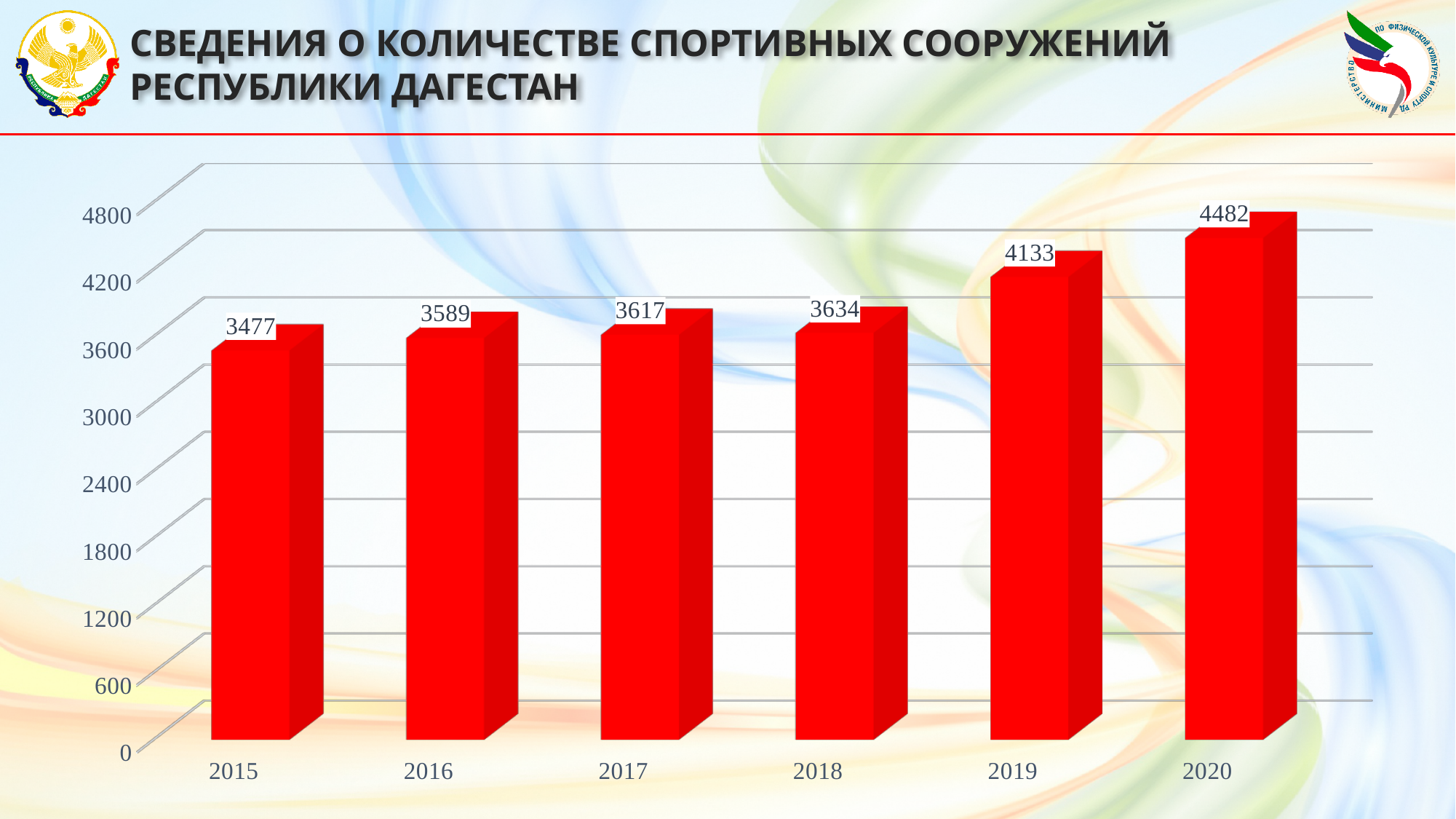
What is the value for 2020? 4482 What kind of chart is shown on the slide? bar chart What is the value for 2018? 3634 What is the difference between the values for 2016 and 2015? 112 Which is larger, the value for 2019 or the value for 2018? 2019 What is the difference between the values for 2020 and 2019? 349 Which year has the lowest value? 2015 What is the value for 2015? 3477 Is the value for 2017 greater or less than 3000? greater How many years are shown on the x axis? 6 Do the values rise or fall from 2015 to 2020? rise Which year has the highest value? 2020